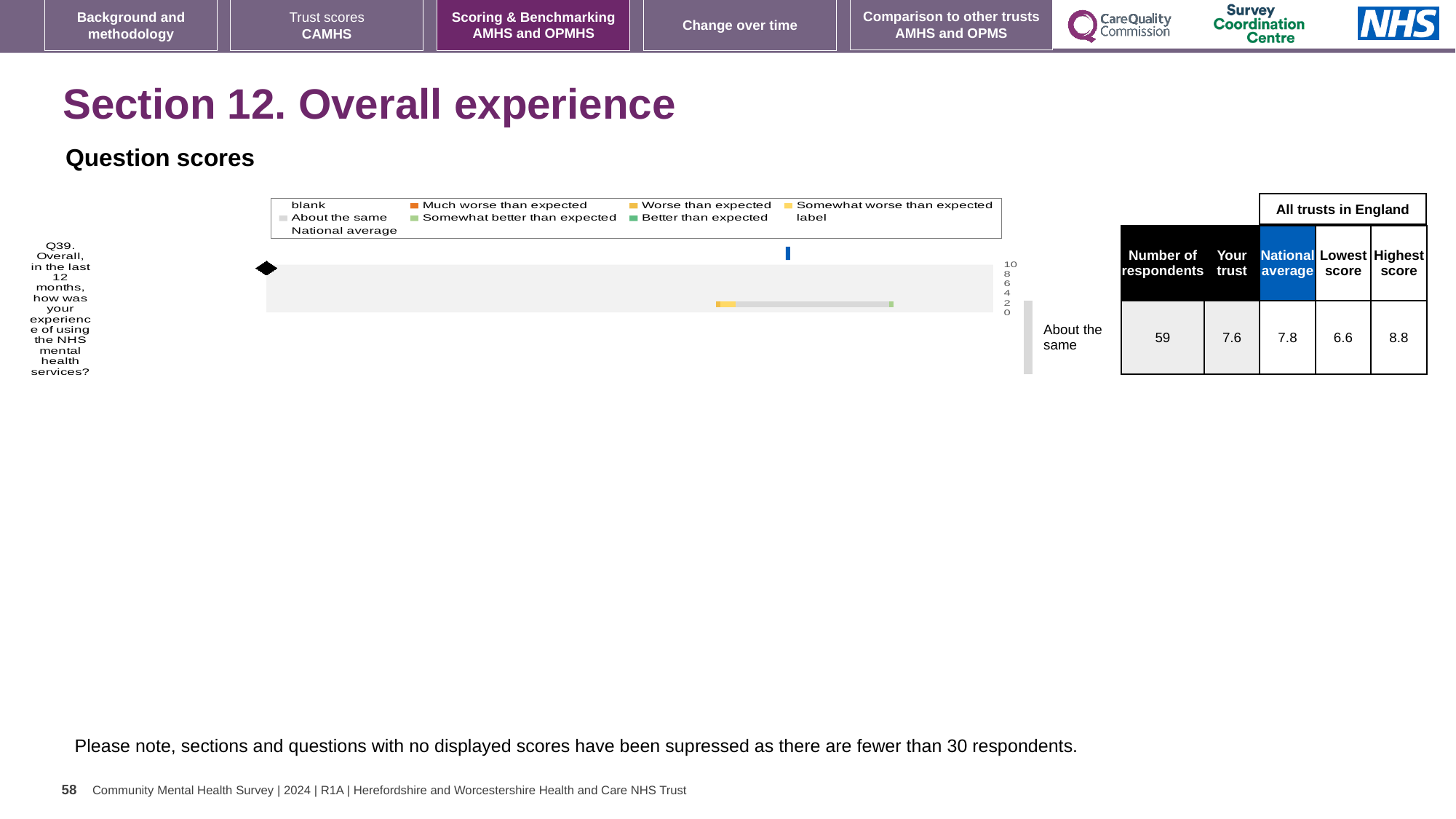
What is the difference between the highest score and the lowest score for Q39 in the table beside the chart? 2.2 According to the table beside the chart, what is the national average score for Q39? 7.8 How many respondents answered Q39, according to the table beside the chart? 59 According to the table beside the chart, what is the 'Your trust' score for Q39? 7.6 Is the 'Your trust' score for Q39 greater or less than 8? less According to the table beside the chart, what is the highest score among all trusts in England for Q39? 8.8 What kind of chart is shown on the slide for Q39? bar chart Which is larger for Q39: the 'Your trust' score or the national average? National average What is the highest value shown on the chart's numeric axis? 10 What benchmark category label is shown to the right of the chart for Q39? About the same How many questions (categories) are plotted in the chart? 1 According to the table beside the chart, what is the lowest score among all trusts in England for Q39? 6.6